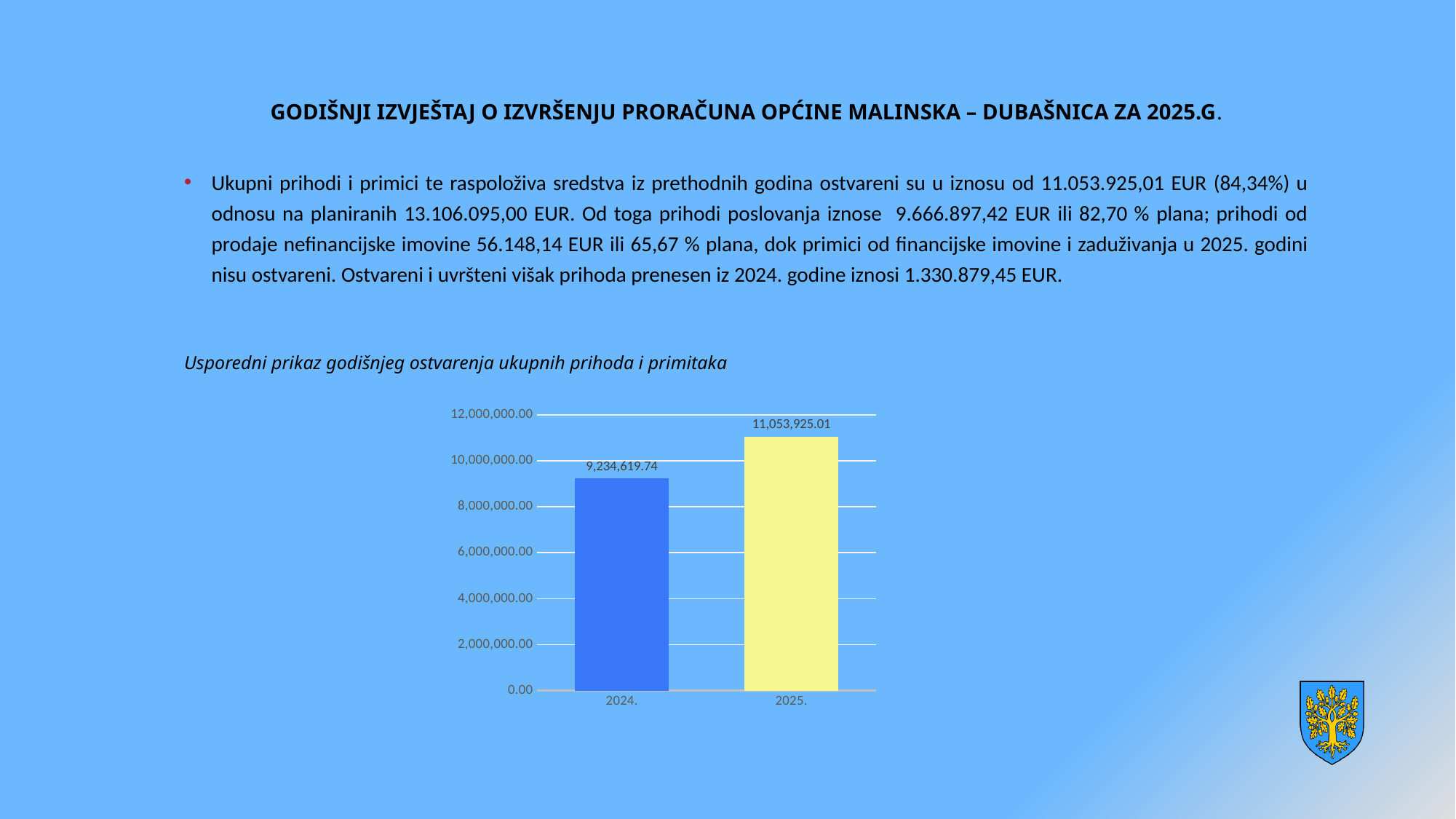
What type of chart is shown on the slide? bar chart How many bars are shown in the chart? 2 What is the difference between the 2025. and 2024. values in the chart? 1,819,305.27 Is the value for 2024. larger or smaller than the value for 2025.? smaller What is the value for 2025. in the bar chart? 11,053,925.01 What colour is the bar for 2025.? yellow Is the value for 2025. greater or less than 10,000,000.00? greater Do the values rise or fall from 2024. to 2025.? rise What is the value for 2024. in the bar chart? 9,234,619.74 Is the value for 2024. greater or less than 10,000,000.00? less Which year has the lower value in the chart? 2024. Which year has the higher value in the chart? 2025.